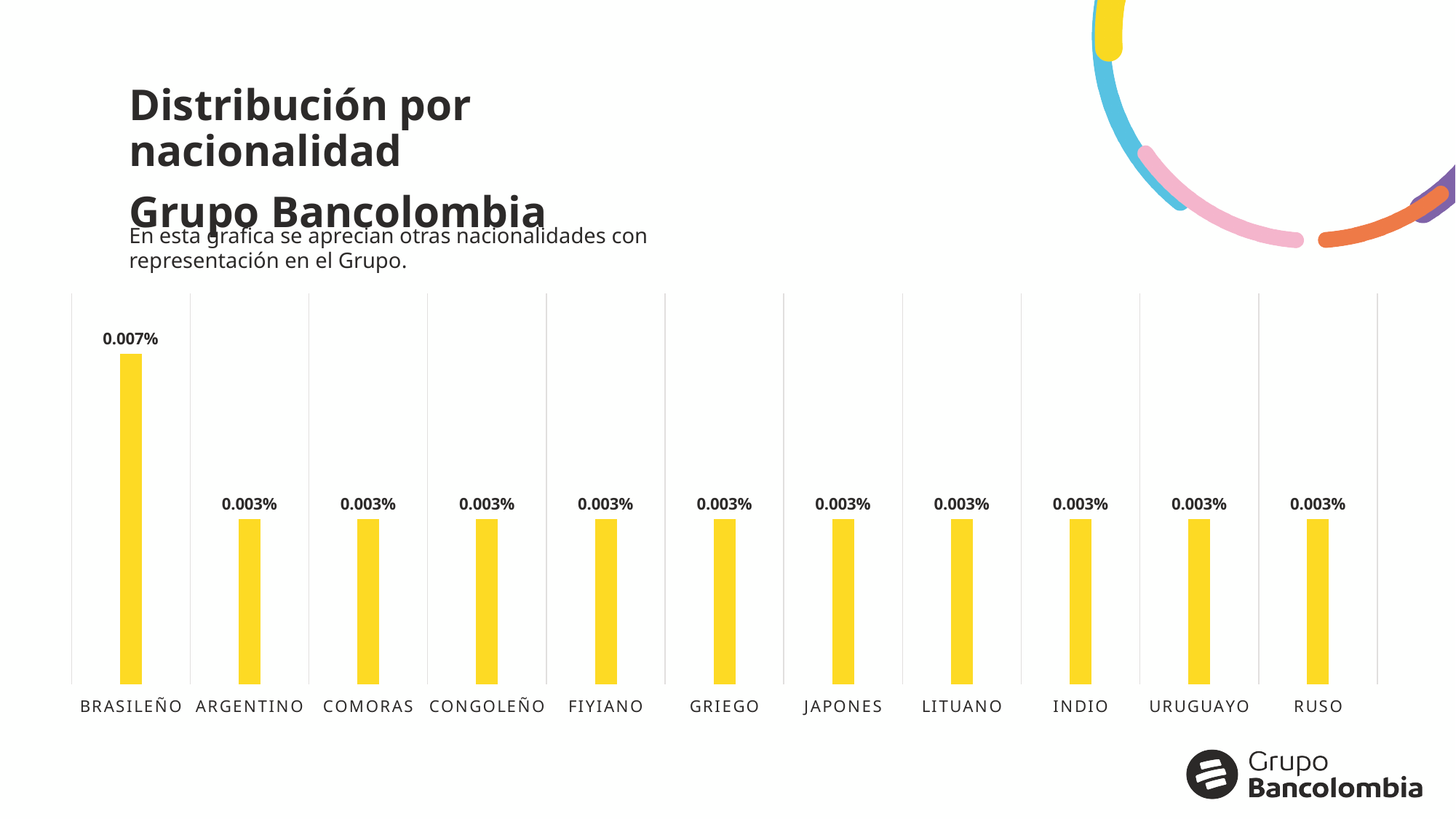
What is the value for BRASILEÑO? 0.007% What is the value for INDIO? 0.003% What is the value for JAPONES? 0.003% What kind of chart is shown on the slide? Bar chart What is the value for RUSO? 0.003% What colour are the bars in the chart? Yellow Which nationality has the highest value? BRASILEÑO What is the title of the slide? Distribución por nacionalidad Grupo Bancolombia How many nationalities are shown in the chart? 11 What is the difference between the values for BRASILEÑO and ARGENTINO? 0.004% How many nationalities have a value of 0.003%? 10 Which is larger, the value for BRASILEÑO or the value for GRIEGO? BRASILEÑO